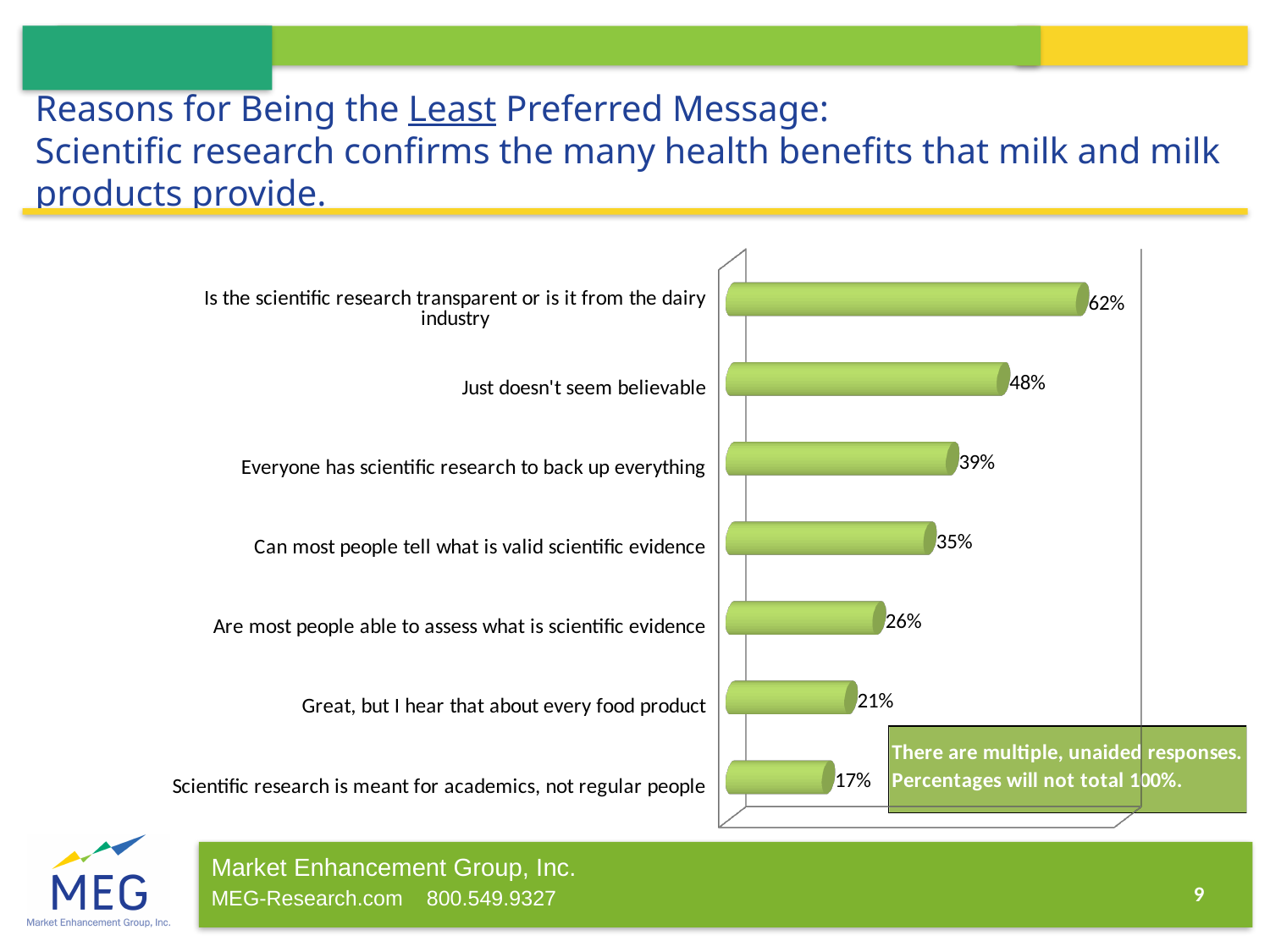
What is the difference in percentage points between "Everyone has scientific research to back up everything" and "Great, but I hear that about every food product"? 18 Do the percentages increase or decrease going from the top bar to the bottom bar? Decrease Which has a higher percentage: "Are most people able to assess what is scientific evidence" or "Great, but I hear that about every food product"? Are most people able to assess what is scientific evidence What kind of chart is shown on the slide? Bar chart What percentage is shown for "Can most people tell what is valid scientific evidence"? 35% What percentage is shown for "Scientific research is meant for academics, not regular people"? 17% What is the difference in percentage points between "Is the scientific research transparent or is it from the dairy industry" and "Just doesn't seem believable"? 14 Which reason has the lowest percentage? Scientific research is meant for academics, not regular people What percentage is shown for "Just doesn't seem believable"? 48% Which reason has the highest percentage? Is the scientific research transparent or is it from the dairy industry What colour are the bars in the chart? Green How many reasons are plotted in the chart? 7